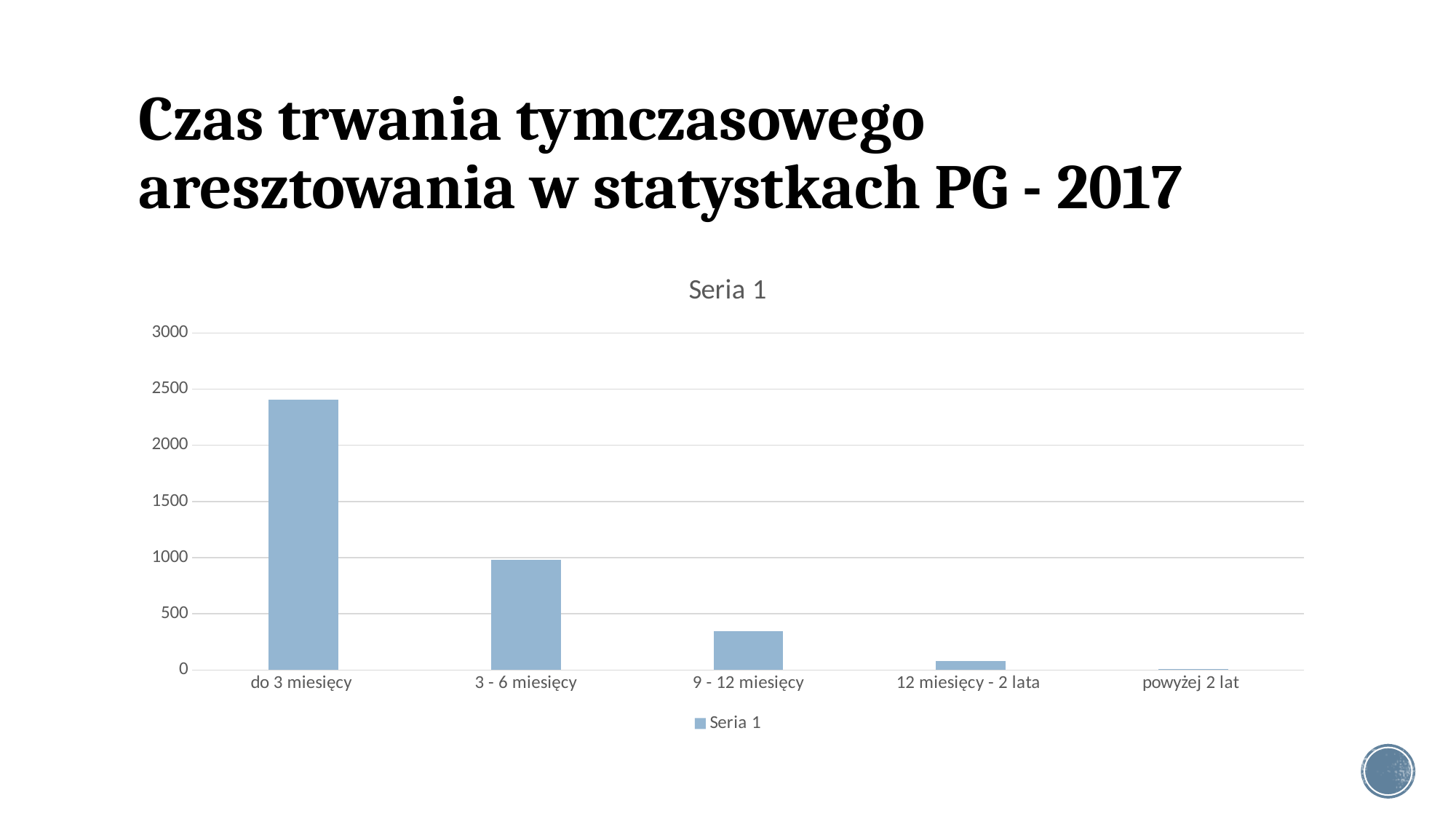
Which category has the highest value in the chart? do 3 miesięcy Is the value for 9 - 12 miesięcy greater or less than 500? less How many categories are shown on the x axis of the chart? 5 Which category has the lowest value in the chart? powyżej 2 lat What is the highest value shown on the vertical axis of the chart? 3000 How many series does the chart legend list? 1 Is the value for do 3 miesięcy greater or less than 2000? greater What kind of chart is shown on the slide? bar chart Do the values rise or fall moving from left to right along the x axis? fall What is the title of the chart? Seria 1 Which is larger, the value for 3 - 6 miesięcy or the value for 9 - 12 miesięcy? 3 - 6 miesięcy